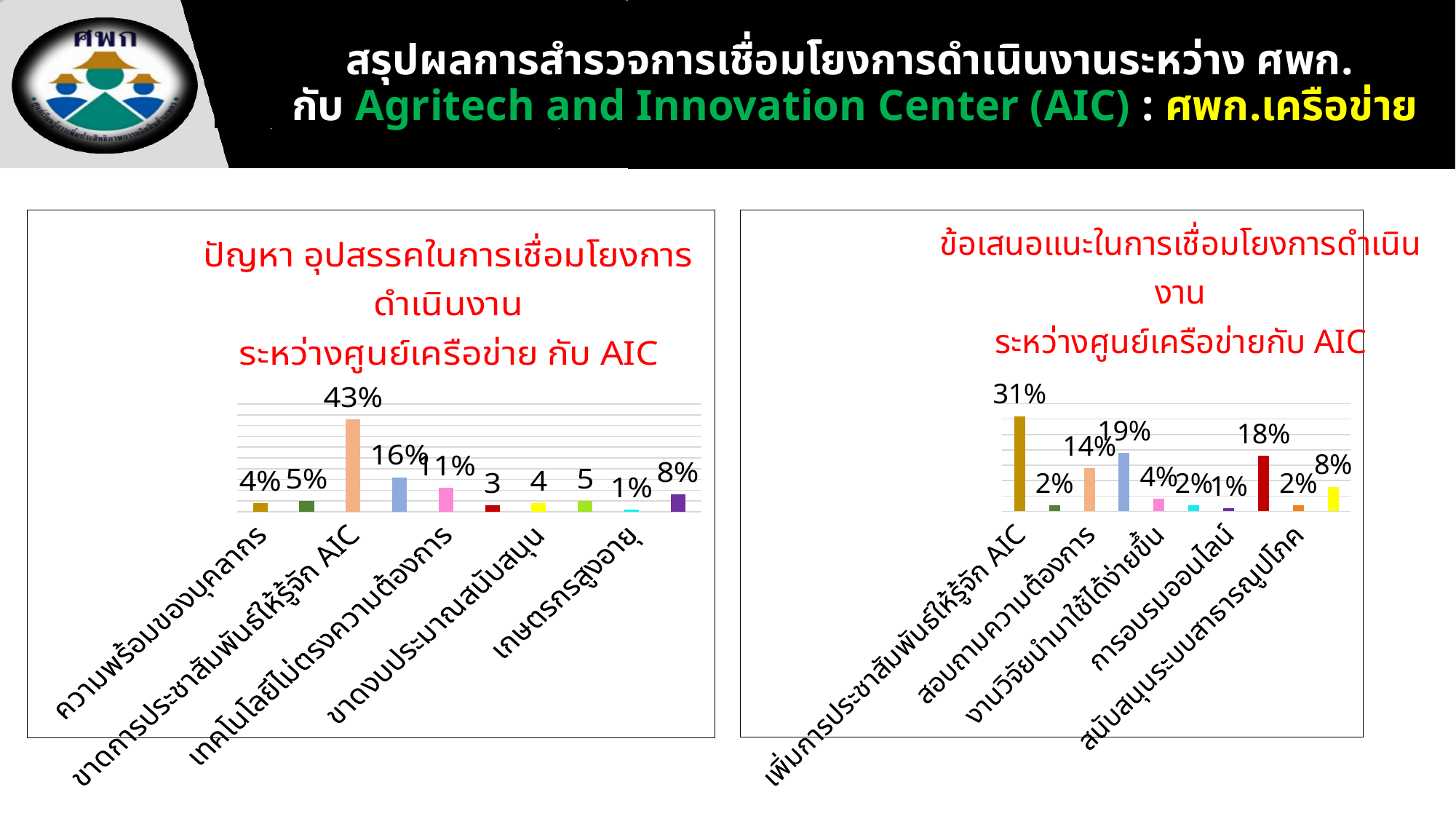
What type of chart is the left chart (ปัญหา อุปสรรคในการเชื่อมโยงการดำเนินงาน)? Bar chart In the left chart (ปัญหา อุปสรรค), what is the highest value shown? 43% In the left chart (ปัญหา อุปสรรค), what is the value for ความพร้อมของบุคลากร? 4% How many bars are plotted in the right chart (ข้อเสนอแนะ)? 10 In the left chart (ปัญหา อุปสรรค), what is the lowest labelled value? 1% How many charts are shown on the slide? 2 In the right chart (ข้อเสนอแนะ), what is the value for สอบถามความต้องการ? 14% How many bars are plotted in the left chart (ปัญหา อุปสรรค)? 10 In the right chart (ข้อเสนอแนะ), which category has the highest value? เพิ่มการประชาสัมพันธ์ให้รู้จัก AIC In the left chart (ปัญหา อุปสรรค), which category has the highest value? ขาดการประชาสัมพันธ์ให้รู้จัก AIC In the right chart (ข้อเสนอแนะ), which is larger: เพิ่มการประชาสัมพันธ์ให้รู้จัก AIC or สอบถามความต้องการ? เพิ่มการประชาสัมพันธ์ให้รู้จัก AIC In the left chart (ปัญหา อุปสรรค), what is the difference between the highest value (43%) and the second highest value (16%)? 27%